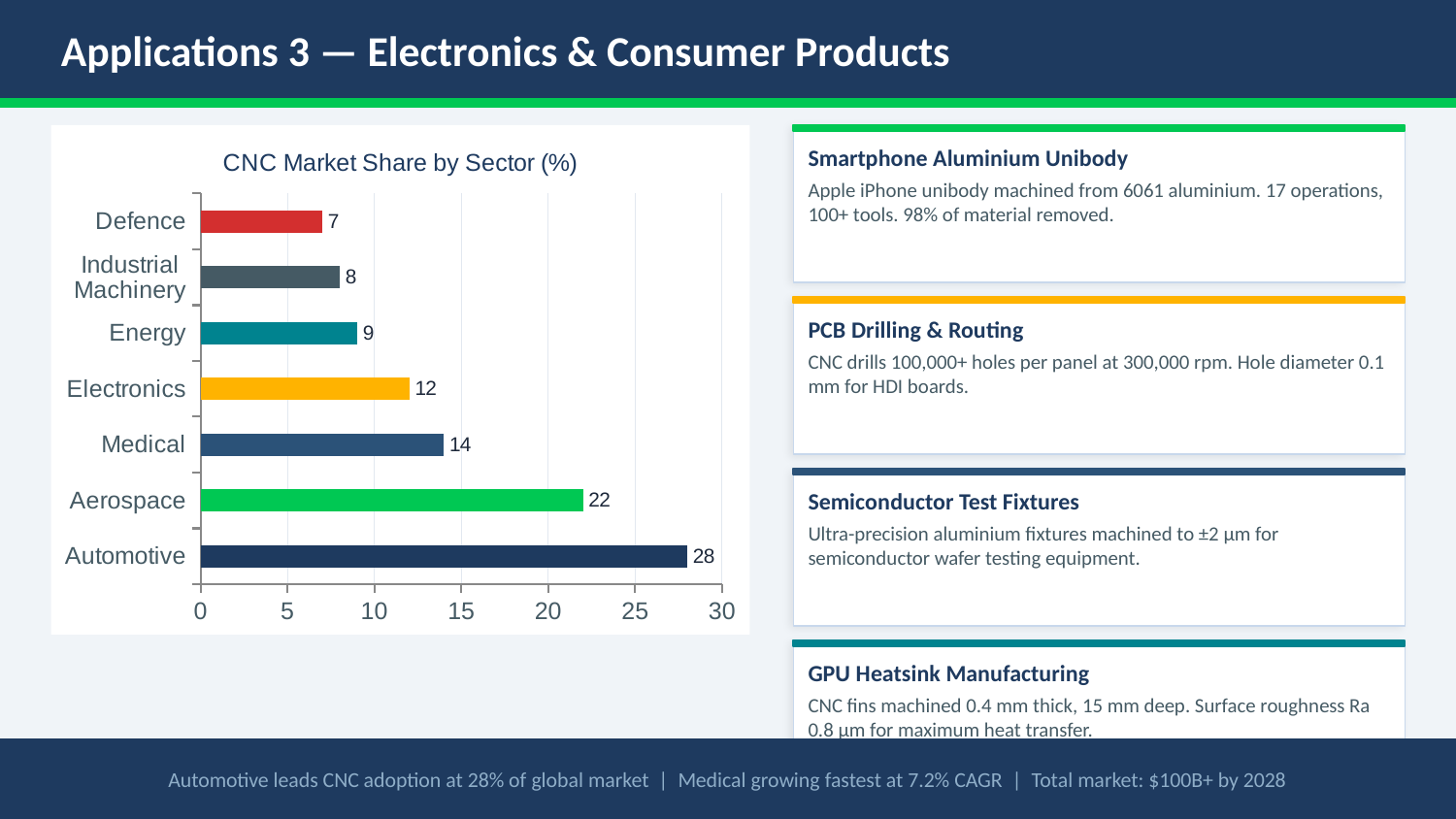
What is the CNC market share for Electronics? 12 Which sector has the highest CNC market share? Automotive What is the difference between the Automotive and Aerospace values? 6 What is the value shown for Industrial Machinery? 8 What is the CNC market share for Aerospace? 22 What kind of chart is shown on the slide? Bar chart What is the title of the chart? CNC Market Share by Sector (%) What is the difference between the Medical and Energy values? 5 How many sectors are shown in the chart? 7 Is the value for Aerospace greater or less than 20? greater Which sector has the lowest CNC market share? Defence Which has a larger market share, Medical or Electronics? Medical